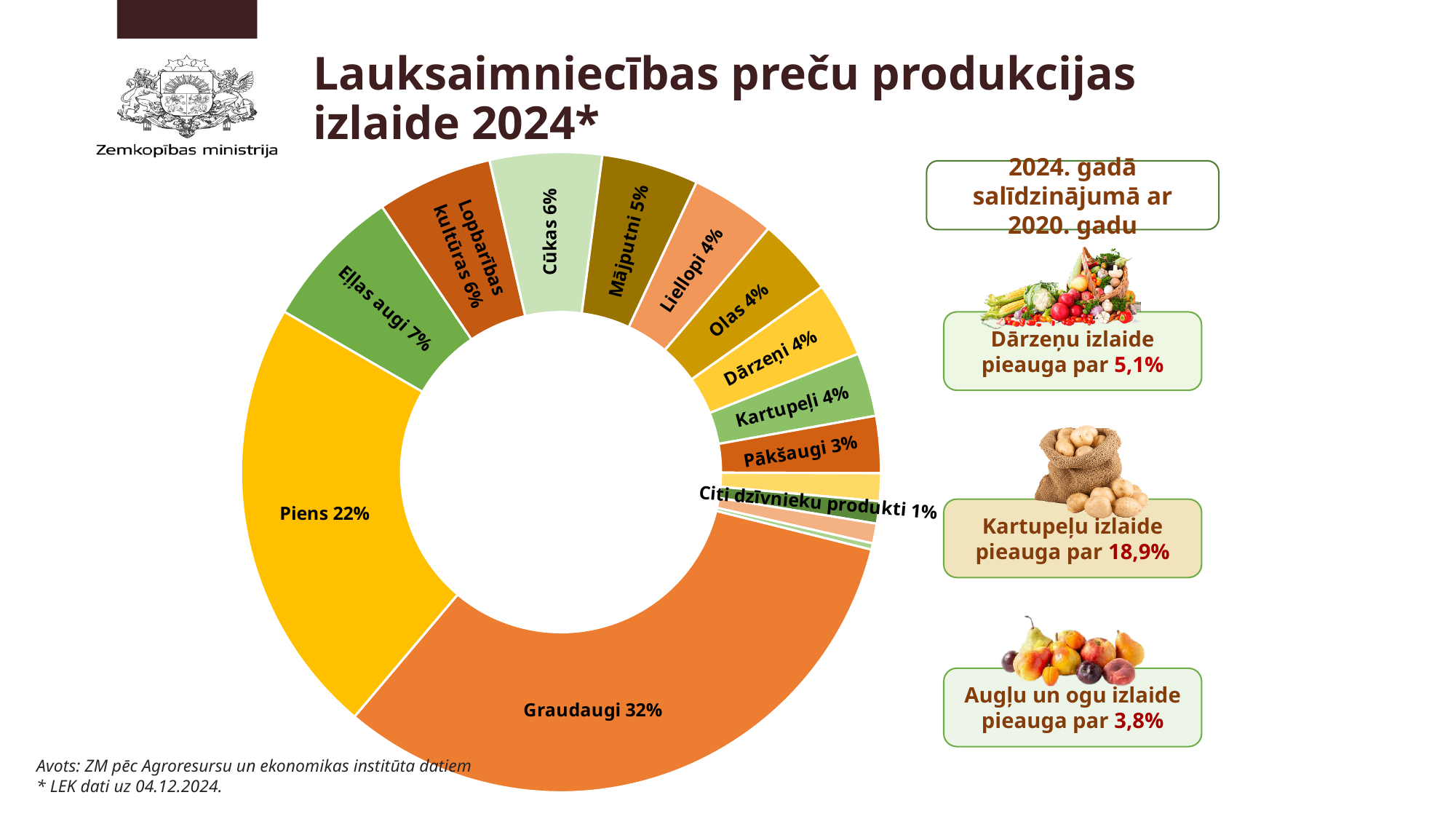
By how many percentage points does the share of Graudaugi exceed the share of Piens? 10 percentage points What share of the chart does Piens represent? 22% Which has a larger share, Eļļas augi or Cūkas? Eļļas augi What percentage is shown for Eļļas augi? 7% What is the title of the slide containing the chart? Lauksaimniecības preču produkcijas izlaide 2024* What percentage is shown for Pākšaugi? 3% What kind of chart is shown on the slide? Pie (doughnut) chart What share of the chart does Graudaugi represent? 32% What percentage is shown for Mājputni? 5% Which has a larger share, Piens or Lopbarības kultūras? Piens What percentage is shown for Citi dzīvnieku produkti? 1% Which category has the largest share of the chart? Graudaugi